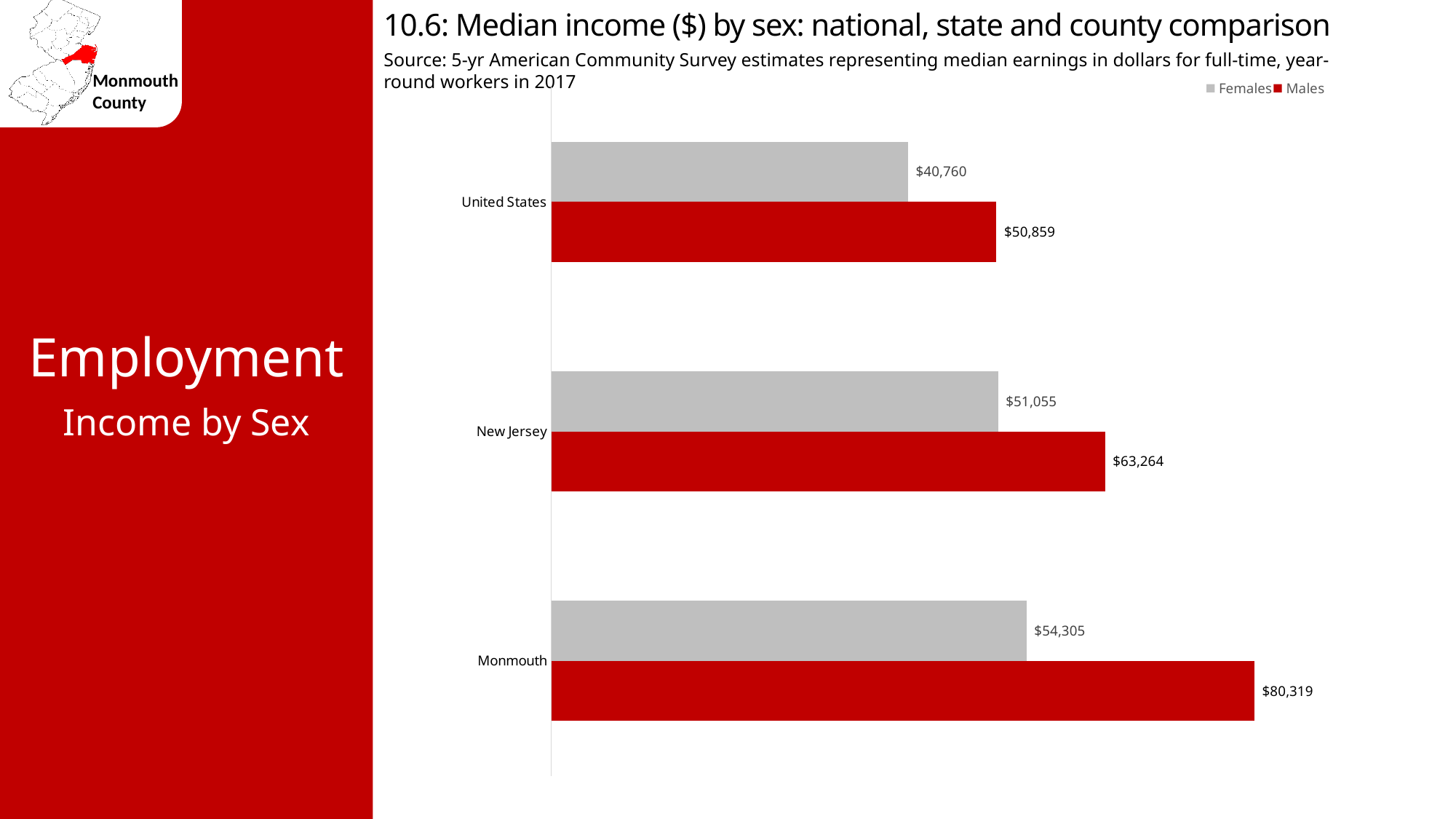
What is the median income for Males in the United States? $50,859 Which geography has the highest median income for Males? Monmouth What kind of chart is shown on the slide? Bar chart What is the median income for Females in New Jersey? $51,055 Which geography has the lowest median income for Females? United States What is the median income for Males in Monmouth? $80,319 What is the median income for Females in the United States? $40,760 How many series does the legend list? 2 What is the difference between the Males and Females median income in Monmouth? $26,014 What is the difference between the Males and Females median income in New Jersey? $12,209 How many geographies are shown on the chart? 3 Which is larger: the Females median income in Monmouth or the Males median income in the United States? Females median income in Monmouth